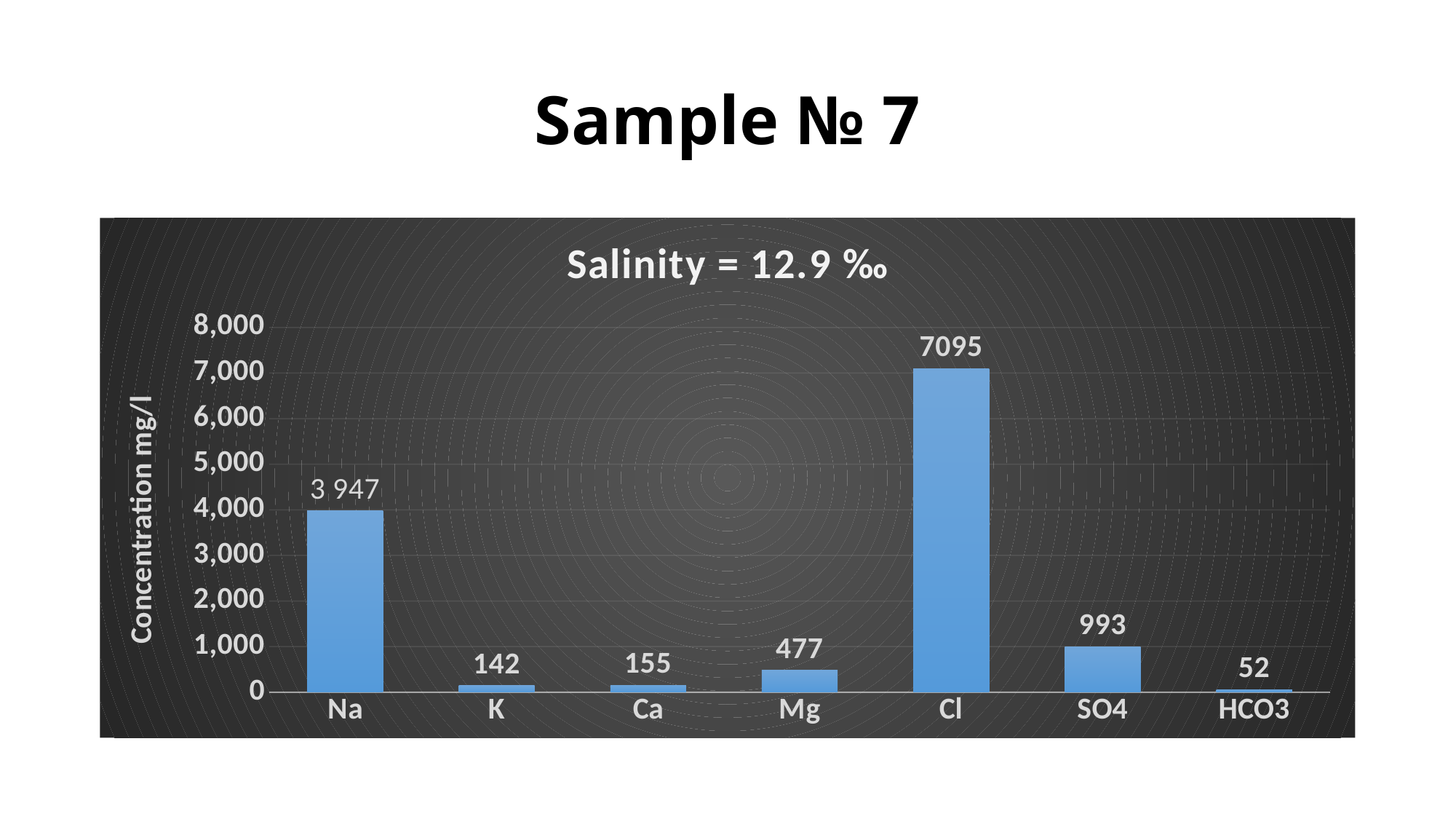
What is the chart's title? Salinity = 12.9 ‰ Which ion has the highest concentration? Cl What is the concentration value shown for HCO3? 52 What kind of chart is shown? Bar chart What is the concentration value shown for SO4? 993 What is the concentration value shown for Cl? 7095 Which has a higher concentration, Mg or SO4? SO4 What is the difference between the concentrations of Ca and K? 13 What is the difference between the concentrations of Cl and Na? 3148 What is the concentration value shown for Na? 3 947 Which ion has the lowest concentration? HCO3 How many ions are shown on the x axis? 7